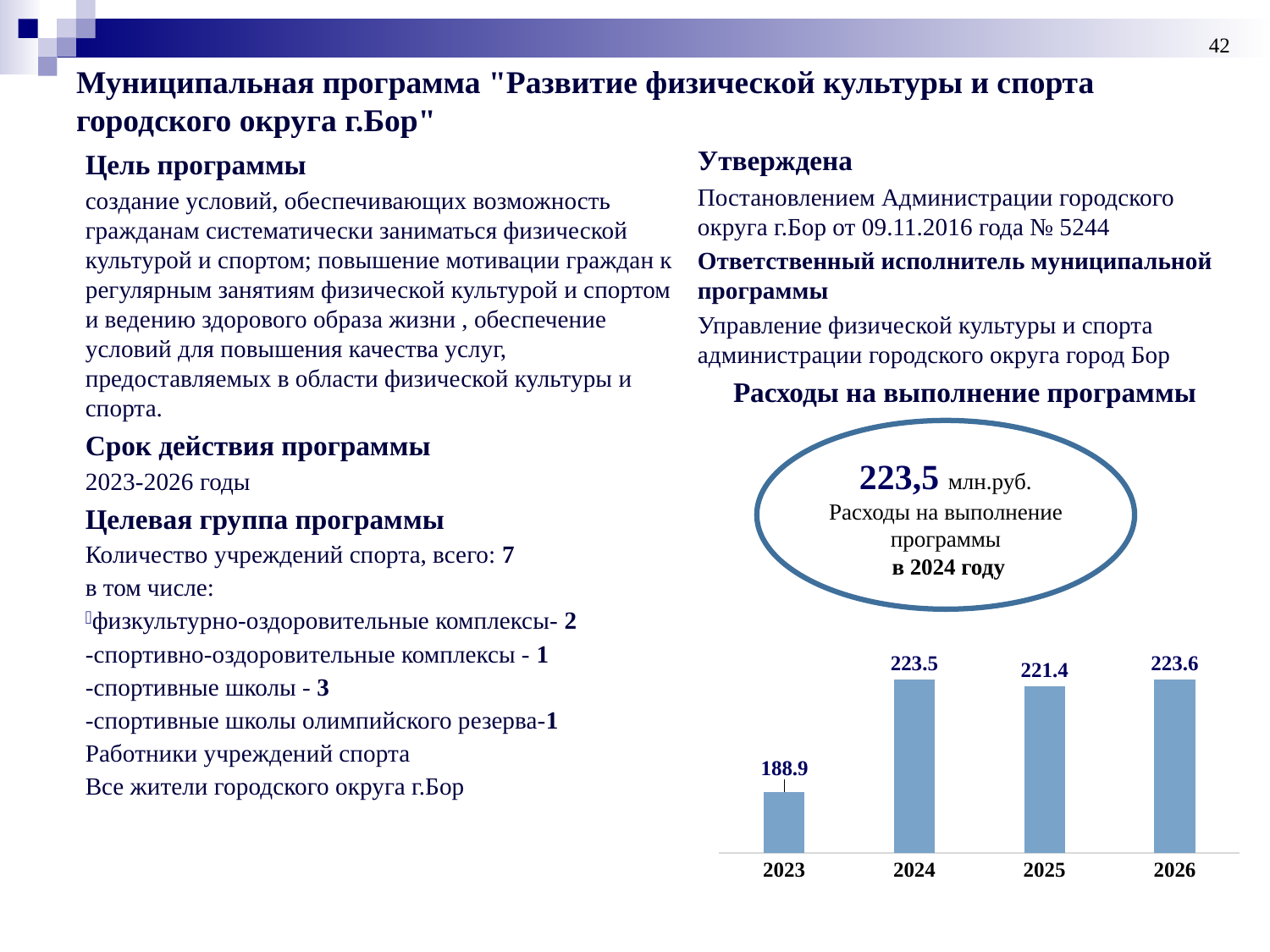
What is the value shown for 2025 in the chart? 221.4 What is the value shown for 2026 in the chart? 223.6 Which year has the lowest value in the chart? 2023 What is the difference between the values for 2024 and 2025 in the chart? 2.1 What type of chart is shown under the heading "Расходы на выполнение программы"? bar chart What is the value shown for 2023 in the chart? 188.9 What is the difference between the values for 2024 and 2023 in the chart? 34.6 Does the value rise or fall from 2023 to 2024 in the chart? rise What is the value shown for 2024 in the chart? 223.5 How many years are shown on the x axis of the chart? 4 Which is larger in the chart, the value for 2025 or the value for 2023? 2025 What is the title of the chart on the slide? Расходы на выполнение программы